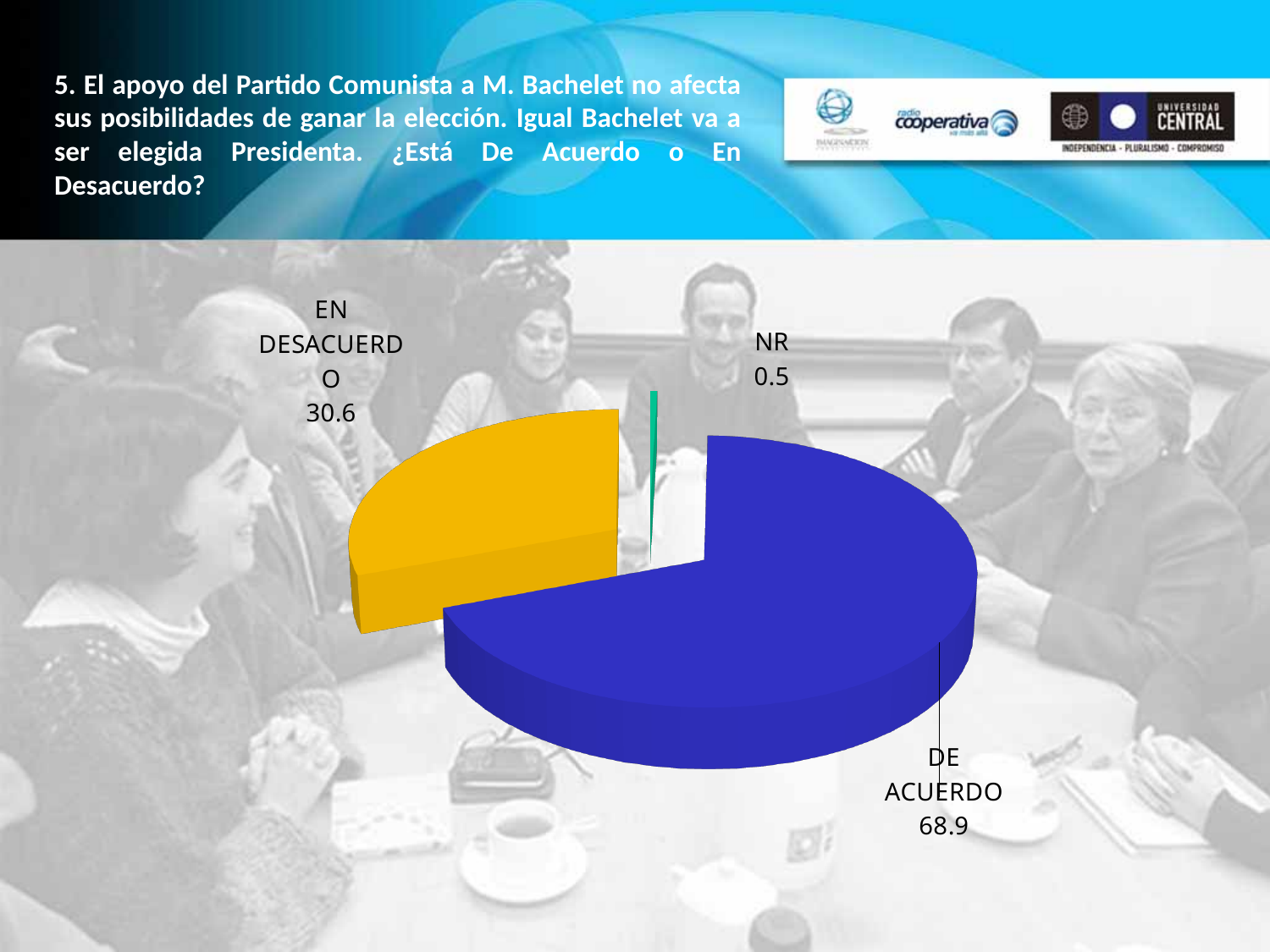
How many slices does the pie chart have? 3 What is the difference between the values for EN DESACUERDO and NR? 30.1 What colour is the DE ACUERDO slice? Blue What is the value for DE ACUERDO? 68.9 What is the value for EN DESACUERDO? 30.6 What kind of chart is shown on the slide? Pie chart Which is larger, the value for EN DESACUERDO or the value for NR? EN DESACUERDO What colour is the EN DESACUERDO slice? Yellow Which category has the smallest slice of the pie? NR Which category has the largest slice of the pie? DE ACUERDO What is the value for NR? 0.5 What is the difference between the values for DE ACUERDO and EN DESACUERDO? 38.3